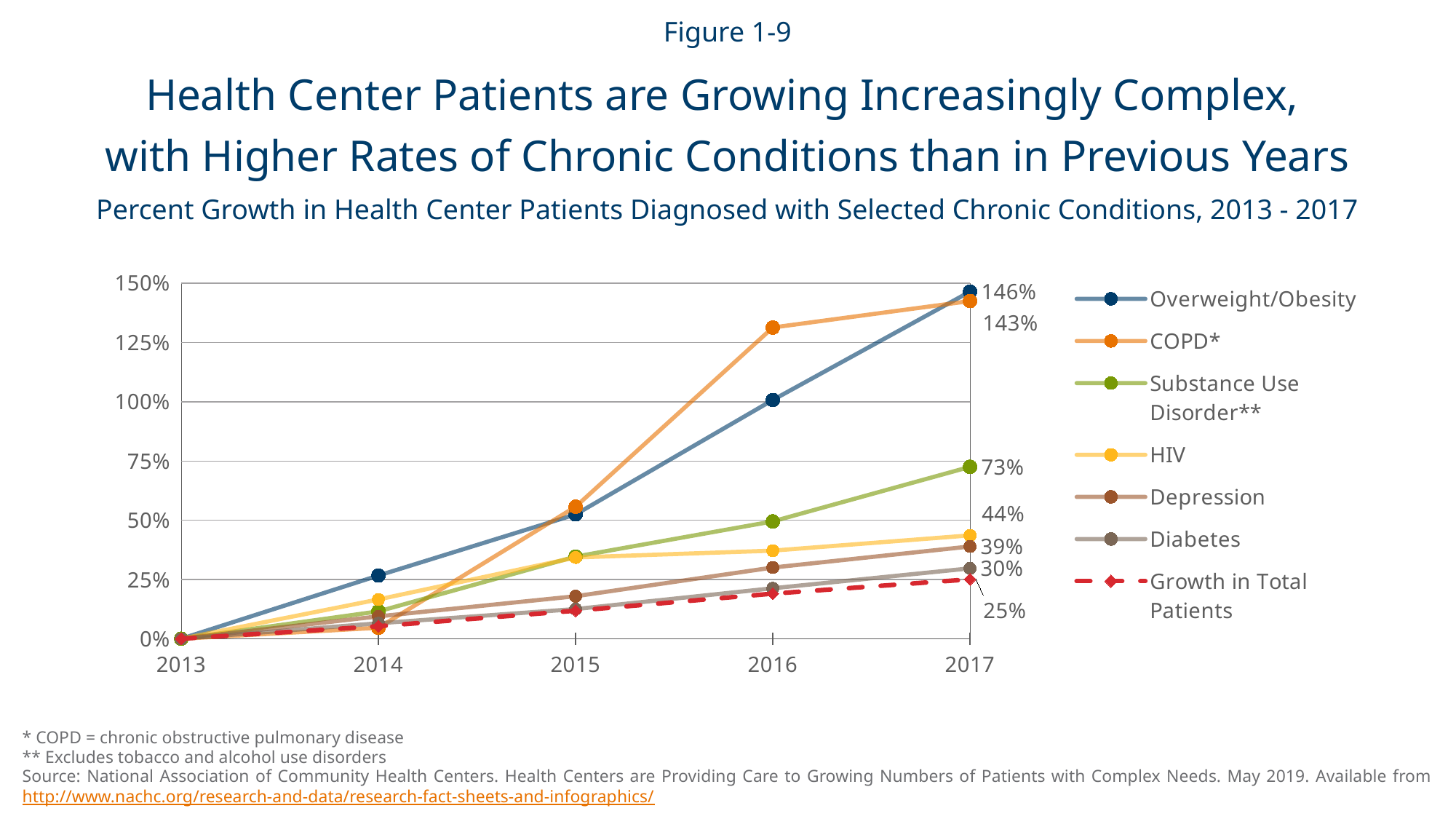
Which series has the highest percent growth in 2017? Overweight/Obesity What is the percent growth for COPD* in 2017? 143% What is the percent growth for Diabetes in 2017? 30% How many series does the legend list? 7 What is the difference between the 2017 values for Substance Use Disorder** and HIV? 29 percentage points What is the percent growth for Substance Use Disorder** in 2017? 73% What kind of chart is shown on the slide? Line chart Is the value for COPD* in 2016 greater or less than 125%? greater Which series has the lowest value in 2017? Growth in Total Patients What is the percent growth for Overweight/Obesity in 2017? 146% What is the Growth in Total Patients in 2017? 25% In 2016, which is higher: COPD* or Overweight/Obesity? COPD*